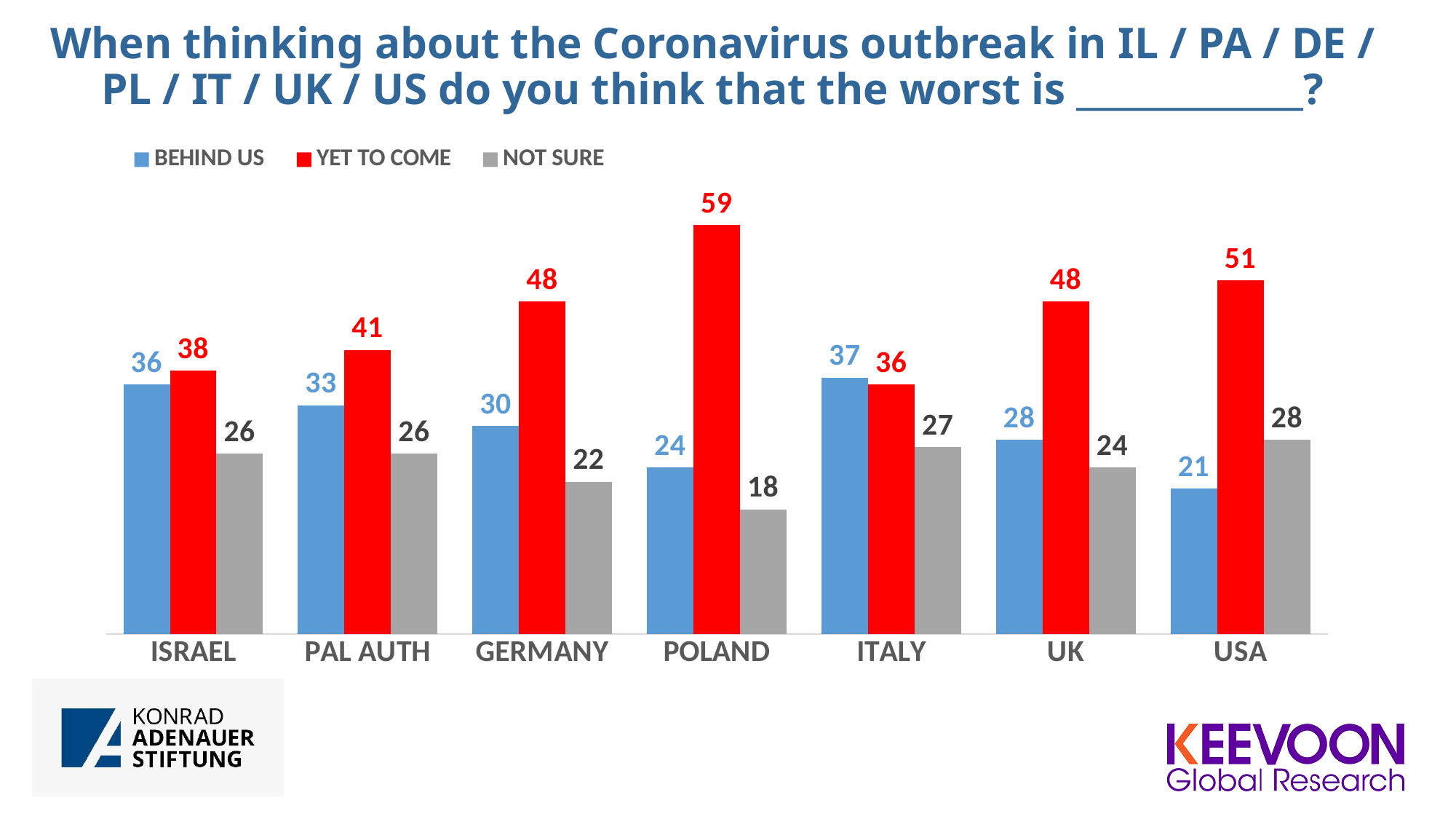
What kind of chart is shown on the slide? Bar chart What is the value for BEHIND US in Italy? 37 What is the value for NOT SURE in Germany? 22 What is the difference between YET TO COME and BEHIND US in Poland? 35 What is the value for YET TO COME in Poland? 59 Which country has the lowest value for BEHIND US? USA How many series does the legend list? 3 Which colour represents the YET TO COME series? Red Which is larger in Italy, BEHIND US or YET TO COME? BEHIND US How many countries are shown on the x axis? 7 Which country has the highest value for YET TO COME? Poland Which country has the lowest value for NOT SURE? Poland